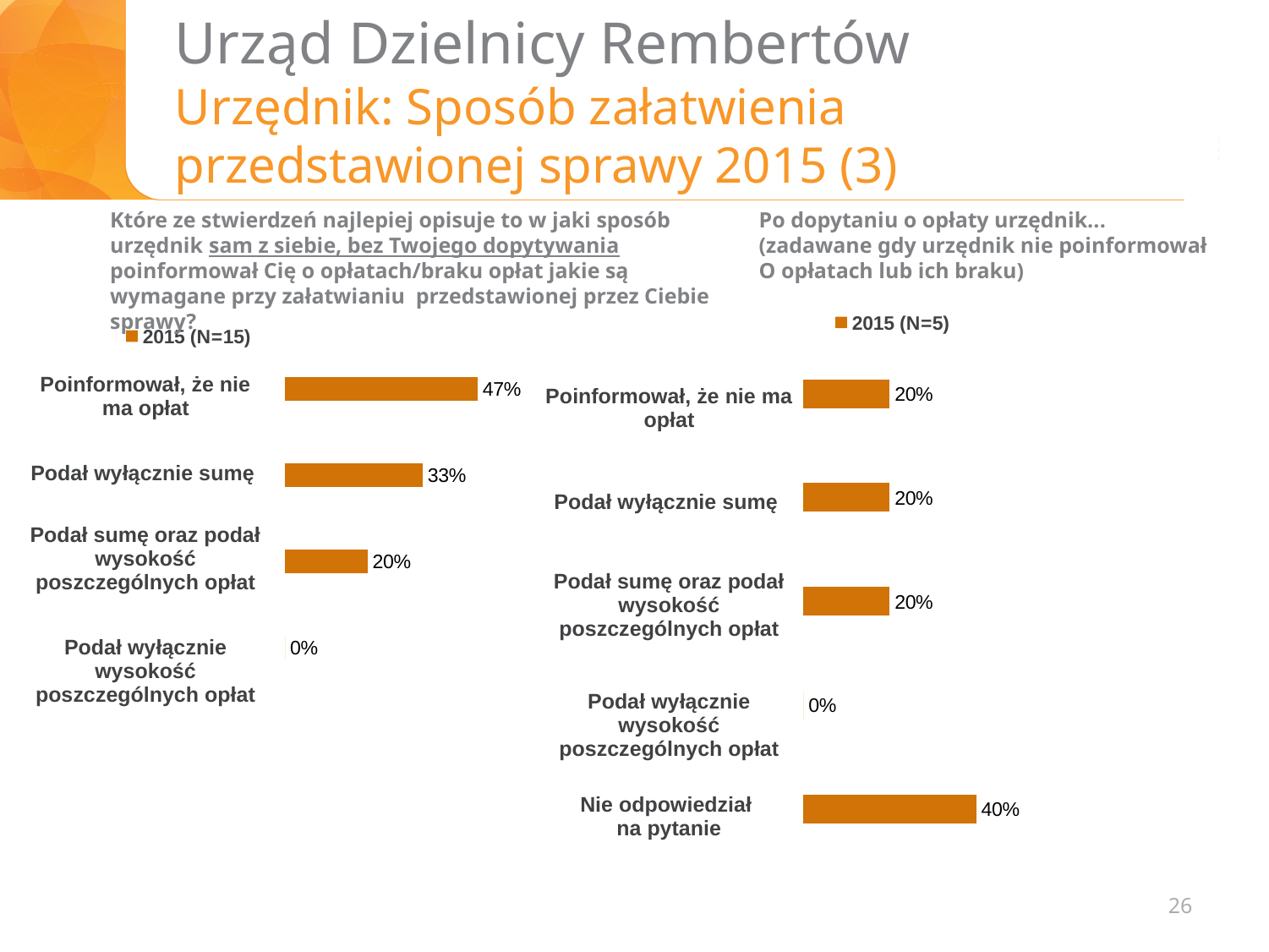
In the left chart (2015, N=15), which category has the lowest value? Podał wyłącznie wysokość poszczególnych opłat In the right chart, what does the legend entry say? 2015 (N=5) In the left chart (2015, N=15), how many categories are shown? 4 In the right chart (2015, N=5), what is the value for "Nie odpowiedział na pytanie"? 40% In the right chart (2015, N=5), which category has the highest value? Nie odpowiedział na pytanie In the right chart (2015, N=5), what is the value for "Podał wyłącznie wysokość poszczególnych opłat"? 0% In the left chart (2015, N=15), what is the value for "Podał wyłącznie sumę"? 33% In the left chart (2015, N=15), which category has the highest value? Poinformował, że nie ma opłat In the right chart (2015, N=5), how many categories are shown? 5 What type of chart is the left chart (2015, N=15)? Bar chart In the left chart (2015, N=15), what is the difference between "Poinformował, że nie ma opłat" and "Podał wyłącznie sumę"? 14% In the left chart (2015, N=15), what is the value for "Poinformował, że nie ma opłat"? 47%